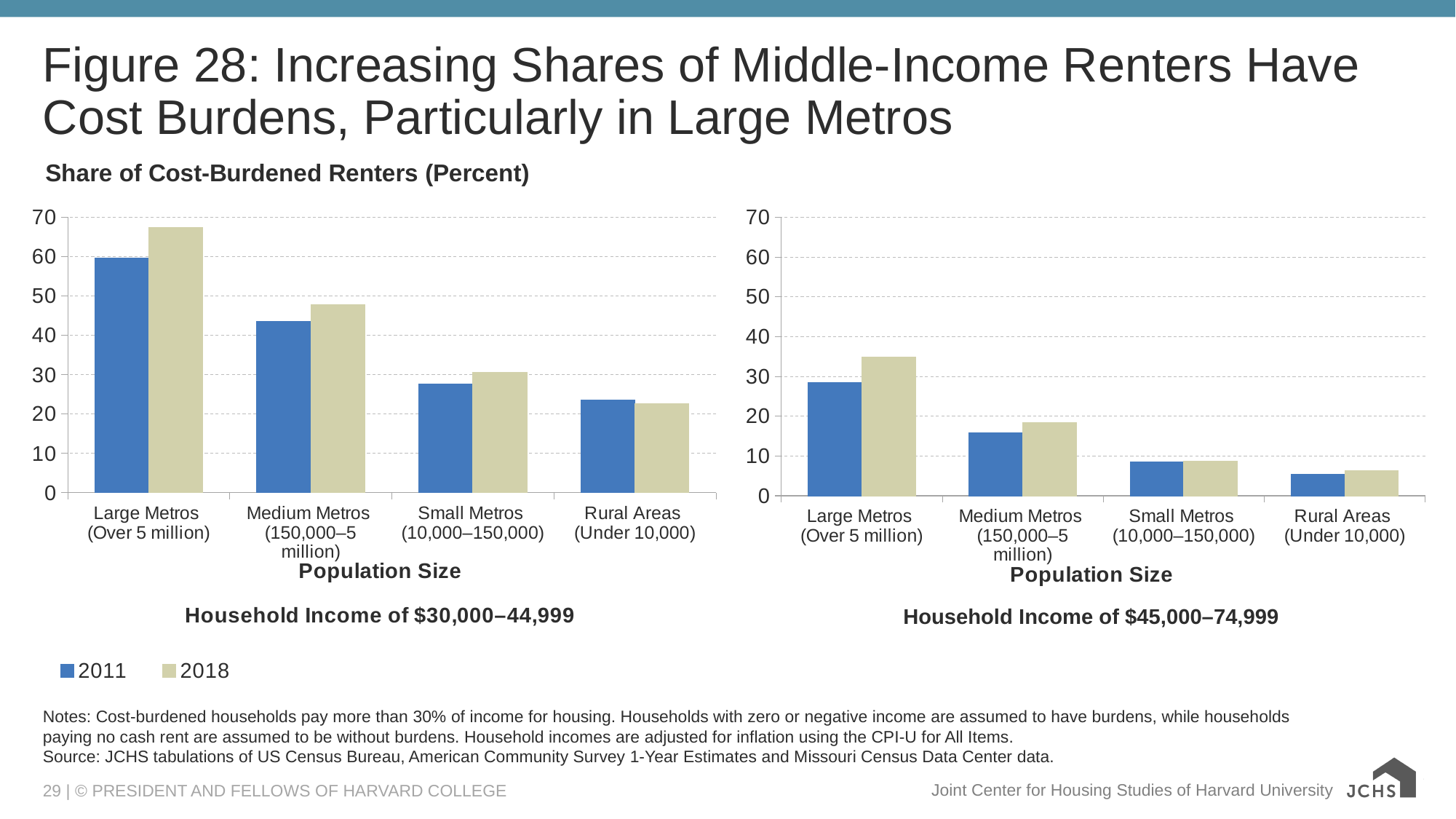
In the Household Income of $30,000–44,999 chart, is the 2011 value for Medium Metros greater or less than 50? less In the Household Income of $45,000–74,999 chart, which is larger for Large Metros: the 2011 value or the 2018 value? 2018 In the Household Income of $45,000–74,999 chart, how many population size categories are shown? 4 In the Household Income of $45,000–74,999 chart, is the 2018 value for Rural Areas greater or less than 10? less What kind of chart is used on this slide for the Household Income of $30,000–44,999 panel? bar chart In the Household Income of $30,000–44,999 chart, which population size category has the highest 2018 value? Large Metros (Over 5 million) In the Household Income of $30,000–44,999 chart, do the 2018 values rise or fall moving from Large Metros to Rural Areas? fall How many series does the legend list? 2 Which colour represents the 2011 series in the legend? blue In the Household Income of $30,000–44,999 chart, which population size category has the lowest 2011 value? Rural Areas (Under 10,000) In the Household Income of $30,000–44,999 chart, is the 2018 value for Large Metros greater or less than 60? greater In the Household Income of $45,000–74,999 chart, which population size category has the highest 2011 value? Large Metros (Over 5 million)